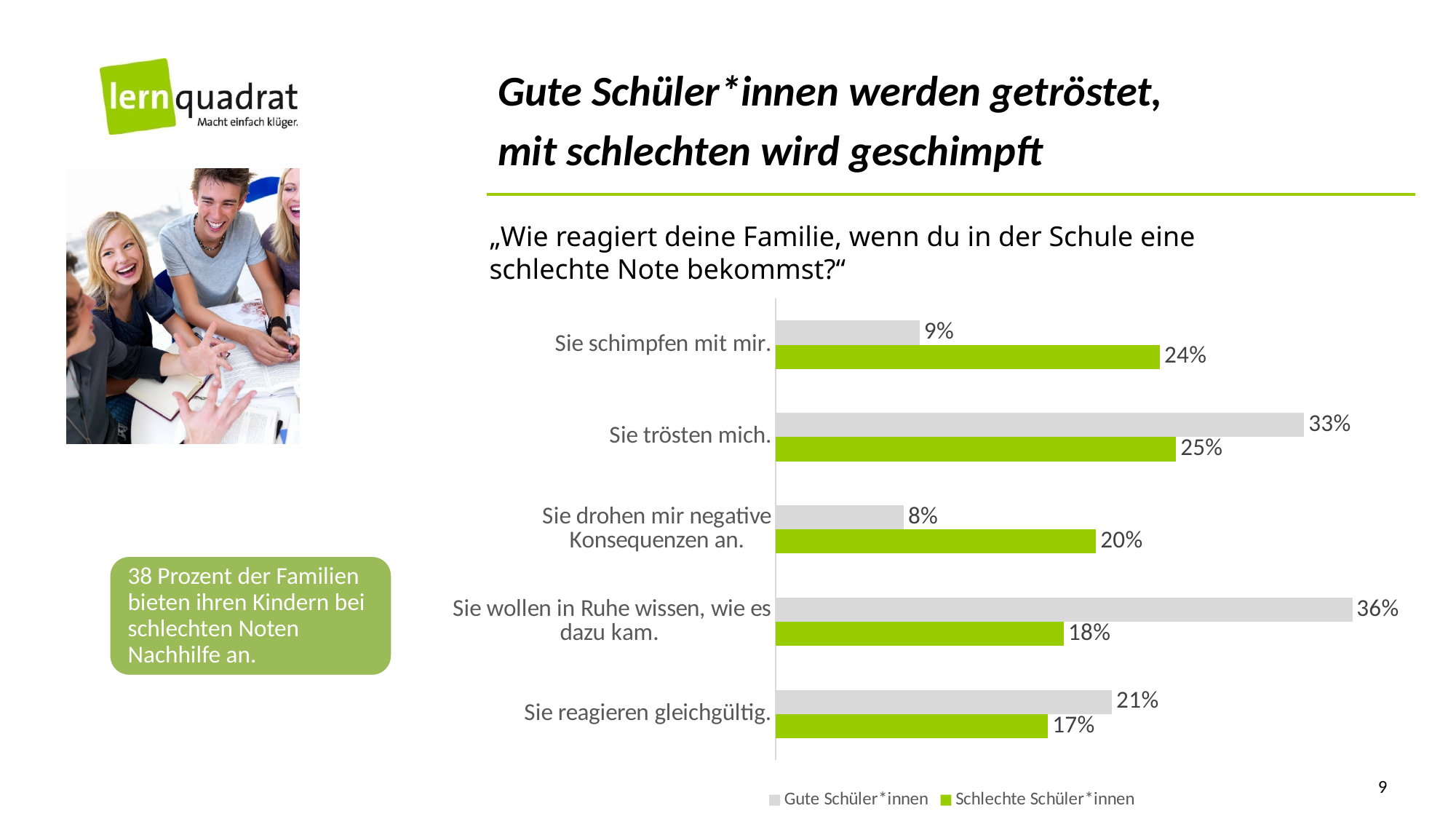
What is the value for Schlechte Schüler*innen for "Sie drohen mir negative Konsequenzen an."? 20% Which colour represents Schlechte Schüler*innen in the chart? Green Which category has the lowest value for Schlechte Schüler*innen? Sie reagieren gleichgültig. What is the difference between Schlechte Schüler*innen and Gute Schüler*innen for "Sie schimpfen mit mir."? 15% How many series does the legend list? 2 How many answer categories are shown in the chart? 5 Which category has the highest value for Gute Schüler*innen? Sie wollen in Ruhe wissen, wie es dazu kam. What percentage of Schlechte Schüler*innen answered "Sie trösten mich."? 25% What percentage of Gute Schüler*innen answered "Sie schimpfen mit mir."? 9% What kind of chart is shown on the slide? Bar chart What is the difference between Gute Schüler*innen and Schlechte Schüler*innen for "Sie wollen in Ruhe wissen, wie es dazu kam."? 18% For "Sie trösten mich.", which group has the larger value, Gute Schüler*innen or Schlechte Schüler*innen? Gute Schüler*innen